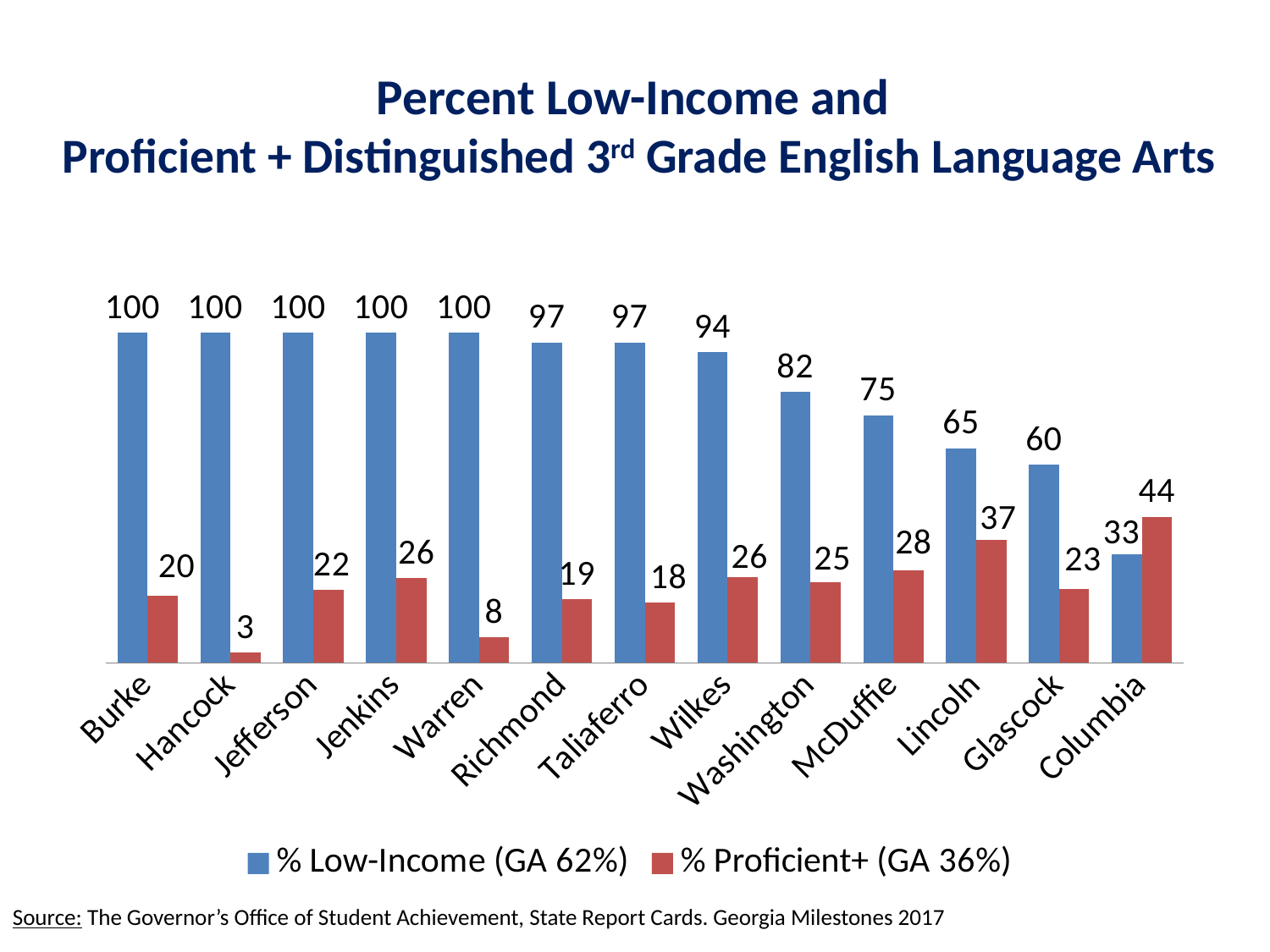
What kind of chart is shown on the slide? Bar chart Which is larger for Lincoln: the % Low-Income value or the % Proficient+ value? % Low-Income Which county has the lowest % Proficient+ value? Hancock What is the difference between the % Low-Income and % Proficient+ values for Warren? 92 What is the % Proficient+ value for Columbia? 44 What is the % Proficient+ value for Hancock? 3 How many counties are shown on the x axis? 13 Which county has the lowest % Low-Income value? Columbia Which county has the highest % Proficient+ value? Columbia How many series does the legend list? 2 What is the Georgia state value for % Proficient+ given in the legend? 36% What is the % Low-Income value for Washington? 82